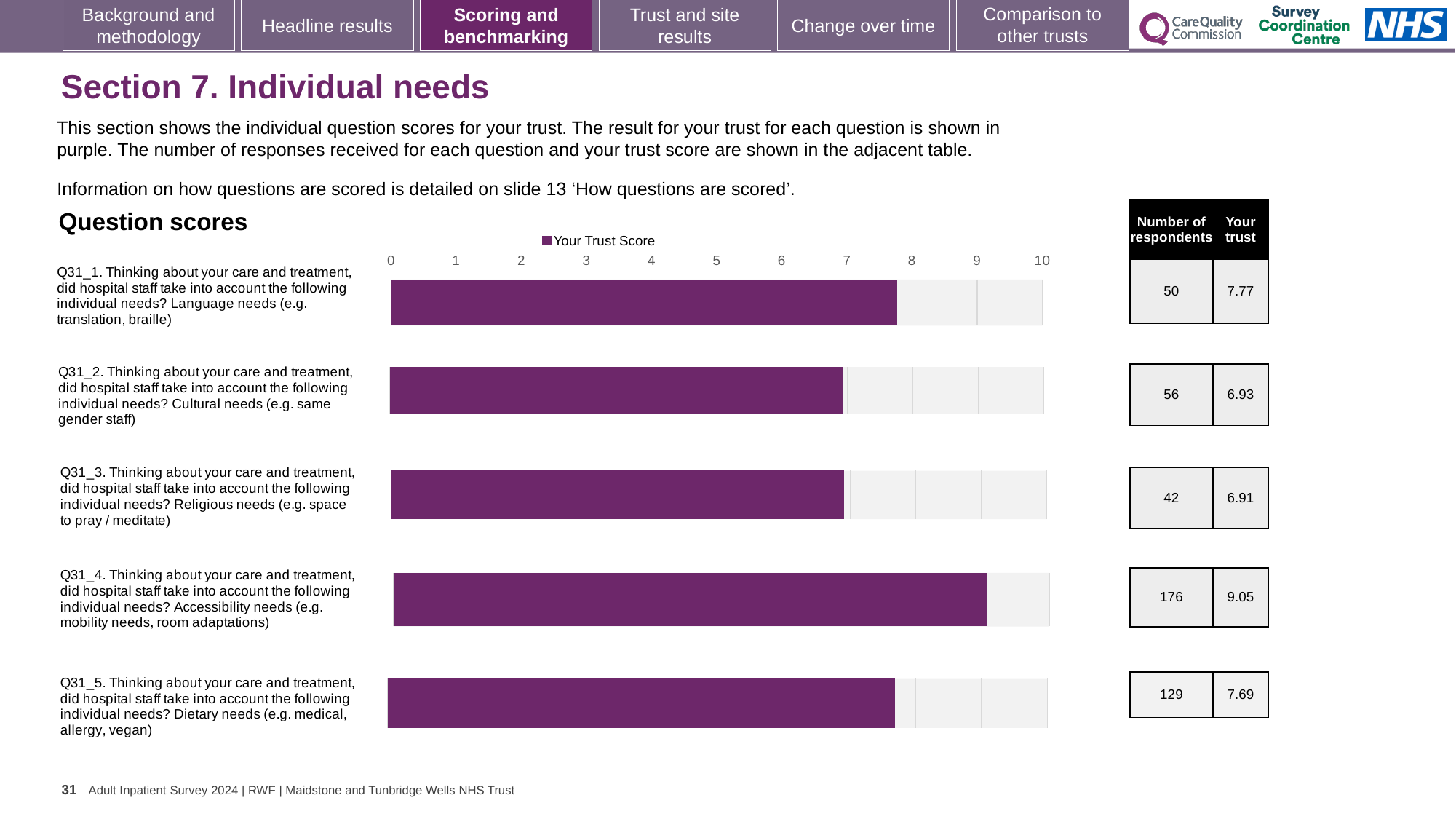
What is the trust score for Q31_4 (Accessibility needs)? 9.05 What type of chart is shown on the slide? Bar chart How many respondents answered Q31_5 (Dietary needs)? 129 Which has the larger trust score, Q31_1 (Language needs) or Q31_2 (Cultural needs)? Q31_1 (Language needs) Is the trust score for Q31_5 (Dietary needs) greater or less than 7? greater What is the name of the series shown in the chart legend? Your Trust Score Which question has the highest trust score? Q31_4 (Accessibility needs) What is the difference between the trust scores for Q31_4 and Q31_1? 1.28 Which question has the lowest trust score? Q31_3 (Religious needs) What is the trust score for Q31_1 (Language needs)? 7.77 How many questions are plotted in the chart? 5 How many series does the chart legend list? 1